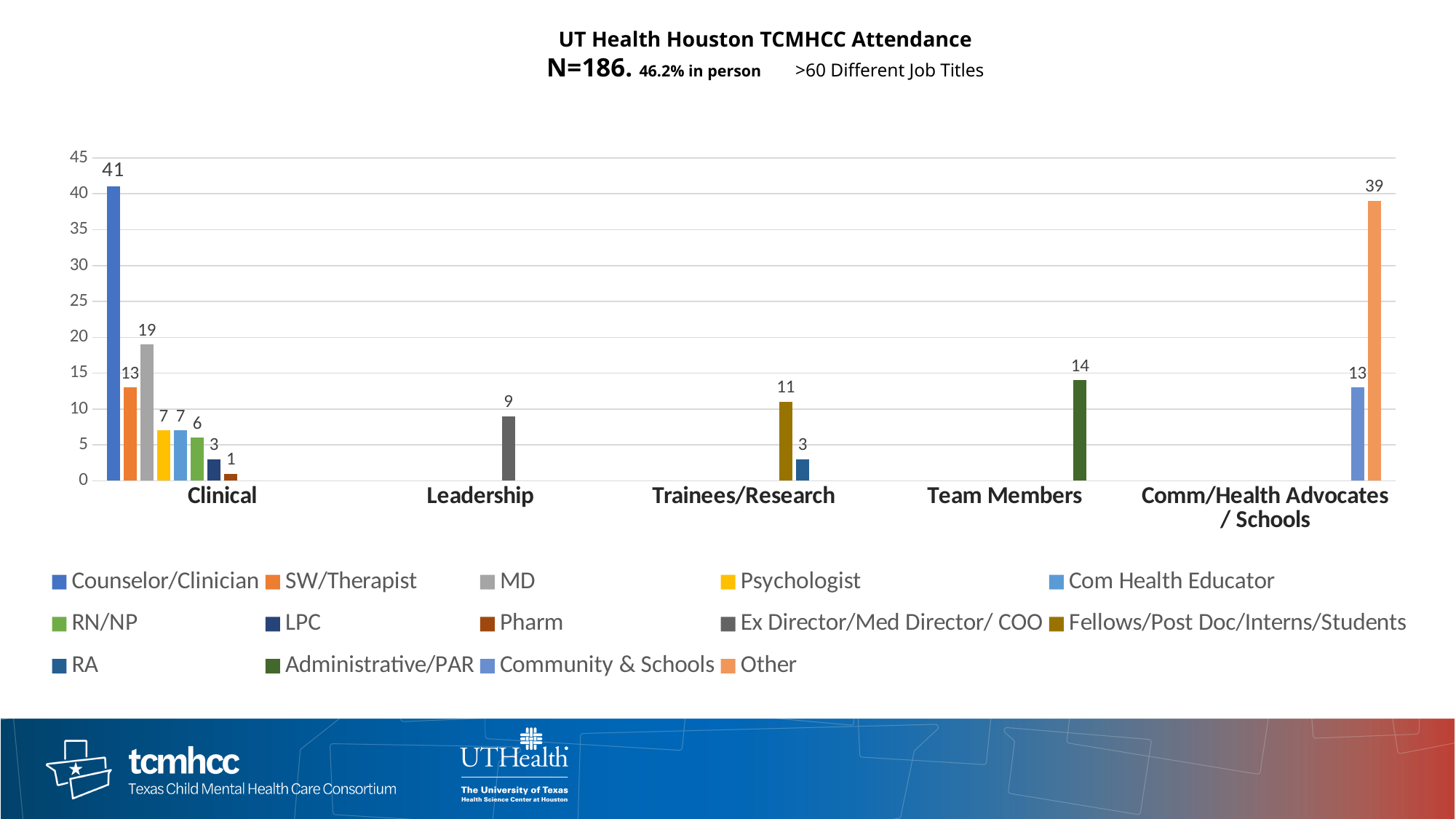
How many series does the legend list? 14 What is the value for MD in the Clinical category? 19 What is the value for Ex Director/Med Director/ COO in the Leadership category? 9 What is the value for Other in the Comm/Health Advocates / Schools category? 39 Which is larger: Fellows/Post Doc/Interns/Students in Trainees/Research or Administrative/PAR in Team Members? Administrative/PAR in Team Members Which series has the highest value in the chart? Counselor/Clinician What kind of chart is shown on the slide? Bar chart What is the difference between the Counselor/Clinician value (41) and the Other value (39)? 2 Which series has the lowest value in the Clinical category? Pharm What is the value for Administrative/PAR in the Team Members category? 14 How many categories are shown on the x axis? 5 What is the value for Counselor/Clinician in the Clinical category? 41